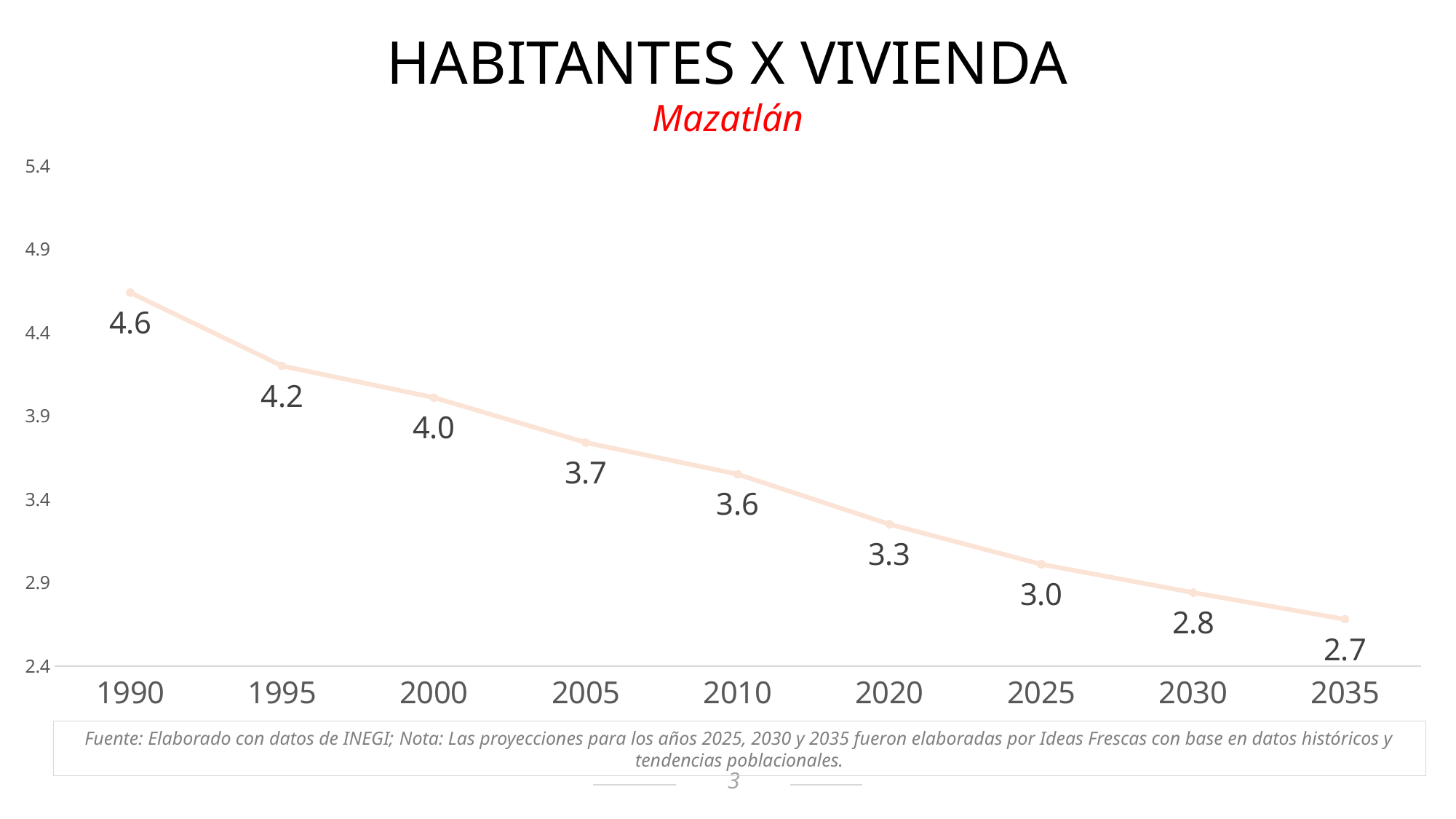
Is the value for 2005 greater or less than 3.4? greater What is the difference between the values for 1990 and 2035? 1.9 How many years are plotted on the x axis? 9 Which year has the lowest value? 2035 What is the difference between the values for 2000 and 2020? 0.7 What is the value for 2010? 3.6 What is the value for 2035? 2.7 Which year has the highest value? 1990 Do the values rise or fall from 1990 to 2035? fall What is the value for 1990? 4.6 Which is larger, the value for 1995 or the value for 2025? 1995 What kind of chart is shown? line chart